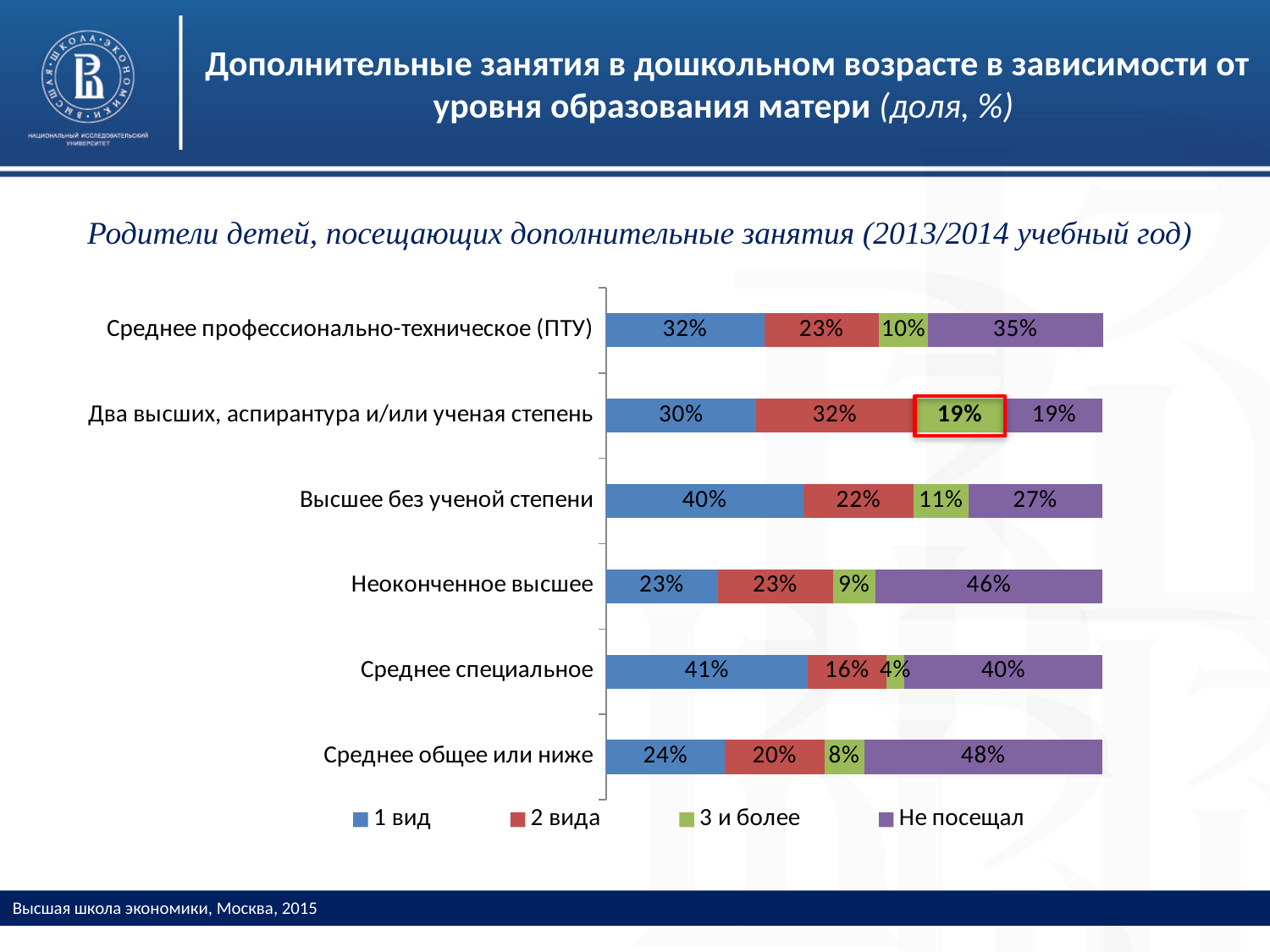
What type of chart is shown on the slide? Stacked bar chart How many education-level categories are plotted on the chart? 6 Which is larger: the "1 вид" value for "Среднее специальное" or for "Среднее профессионально-техническое (ПТУ)"? Среднее специальное Which category has the lowest value for "Не посещал"? Два высших, аспирантура и/или ученая степень Which value on the chart is highlighted with a red box? 19% (3 и более, Два высших, аспирантура и/или ученая степень) What is the difference between the "Не посещал" values for "Среднее общее или ниже" and "Неоконченное высшее"? 2% Which category has the highest value for "3 и более"? Два высших, аспирантура и/или ученая степень What is the value of "Не посещал" for "Среднее общее или ниже"? 48% What is the value of "3 и более" for "Среднее специальное"? 4% How many series does the legend list? 4 What is the value of "2 вида" for "Два высших, аспирантура и/или ученая степень"? 32% What is the value of "1 вид" for "Высшее без ученой степени"? 40%